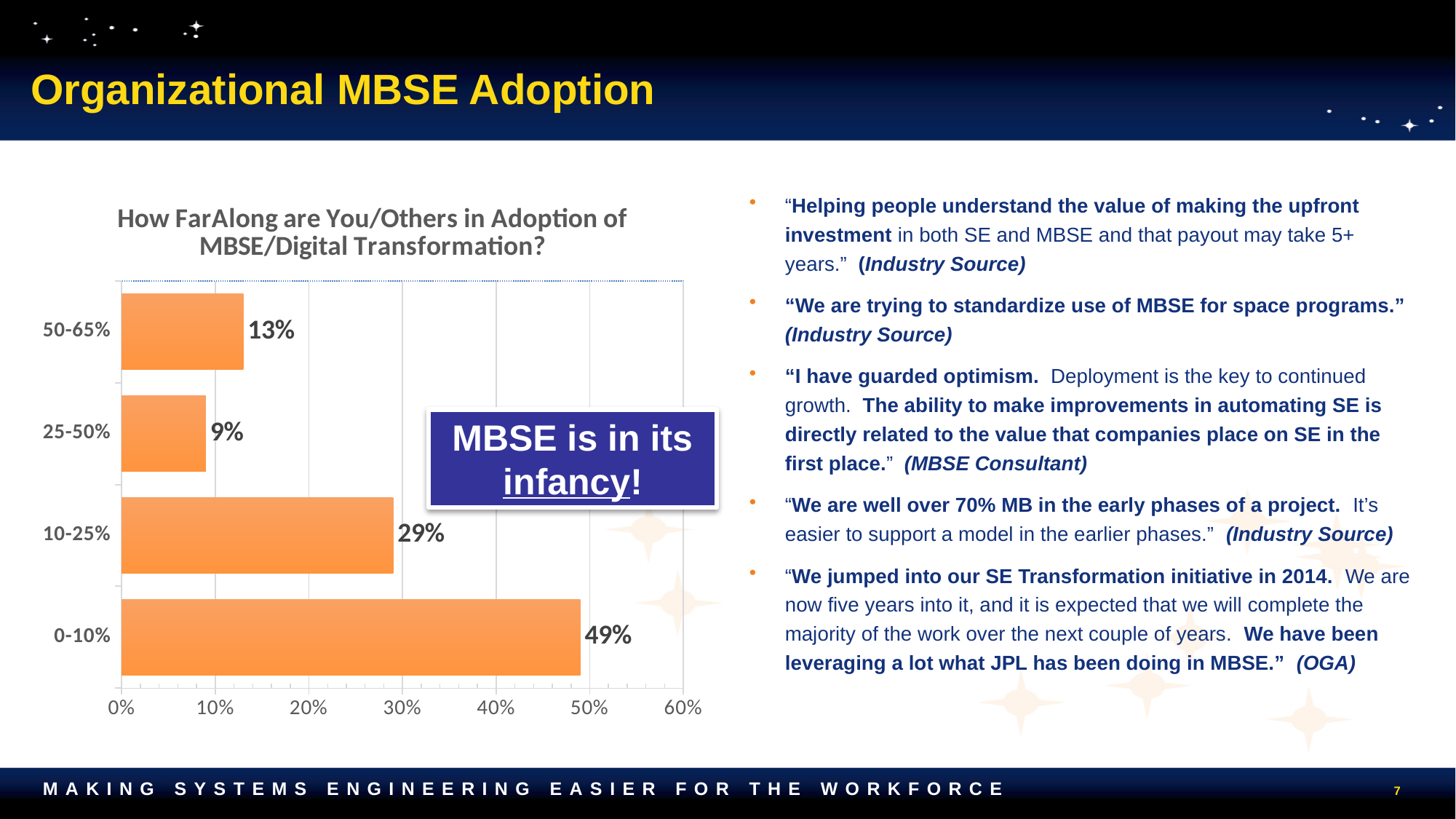
Which adoption range has the lowest value? 25-50% What value is shown for the 50-65% category? 13% Is the value for 10-25% greater or less than 20%? greater What value is shown for the 10-25% category? 29% How many categories are shown in the chart? 4 What is the title of the chart? How FarAlong are You/Others in Adoption of MBSE/Digital Transformation? Which is larger, the value for 50-65% or the value for 25-50%? 50-65% Which adoption range has the highest value? 0-10% What percentage of respondents are in the 0-10% adoption range? 49% What is the difference between the values for 0-10% and 10-25%? 20% What value is shown for the 25-50% category? 9% What type of chart is shown on the slide? Bar chart